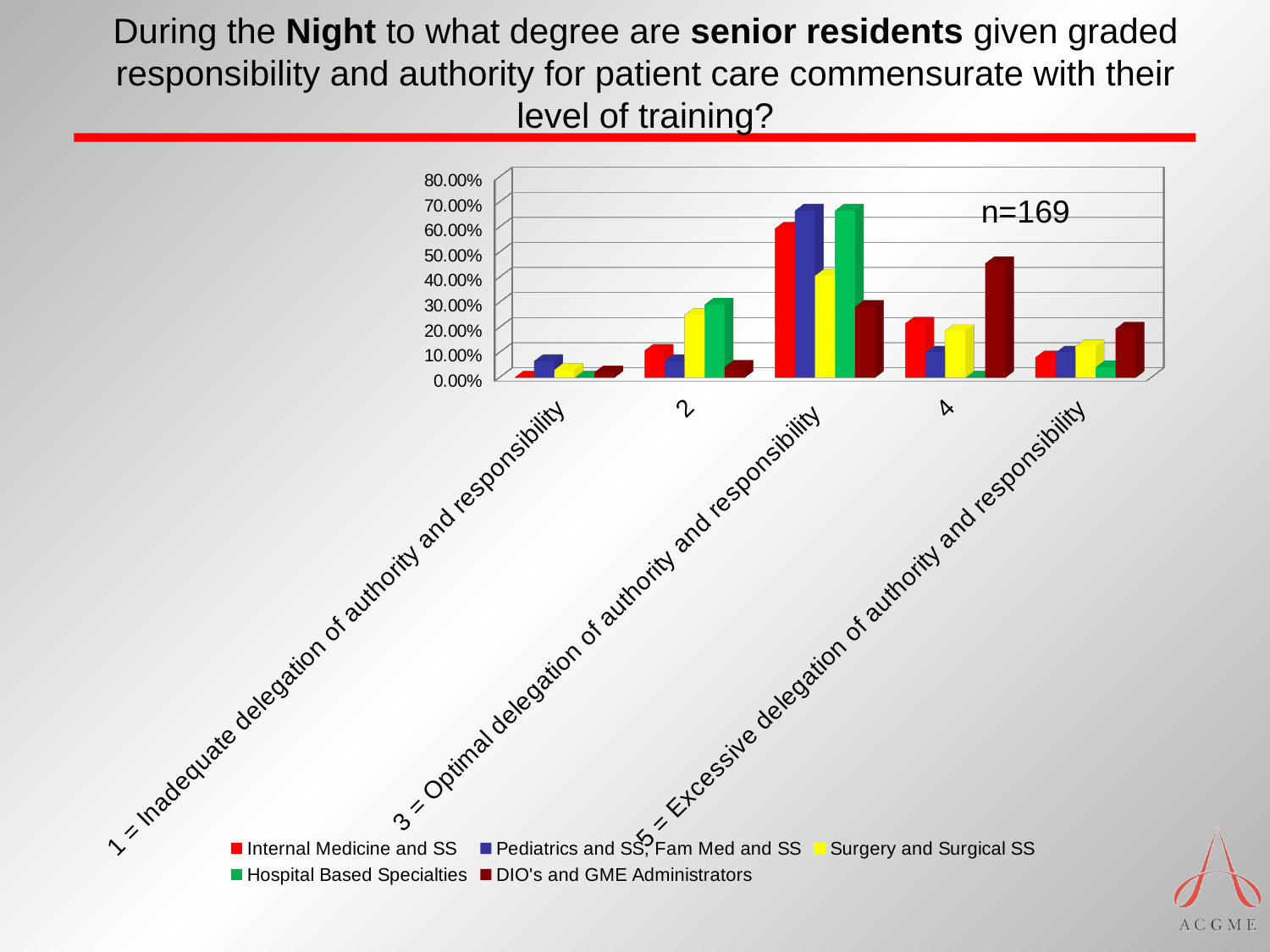
For the Internal Medicine and SS series, which category has the highest value? 3 = Optimal delegation of authority and responsibility Is the value for Hospital Based Specialties at category 2 greater or less than 20.00%? greater For the DIO's and GME Administrators series, which category has the highest value? 4 Is the value for Pediatrics and SS, Fam Med and SS at category 1 (Inadequate delegation) greater or less than 20.00%? less At category 4, which is larger: DIO's and GME Administrators or Hospital Based Specialties? DIO's and GME Administrators How many series does the chart's legend list? 5 At category 3 (Optimal delegation), which is larger: Pediatrics and SS, Fam Med and SS or Surgery and Surgical SS? Pediatrics and SS, Fam Med and SS What sample size (n) is shown on the chart? n=169 How many categories are shown along the x axis of the chart? 5 Is the value for Internal Medicine and SS at category 3 (Optimal delegation) greater or less than 50.00%? greater What kind of chart is shown on the slide? Bar chart